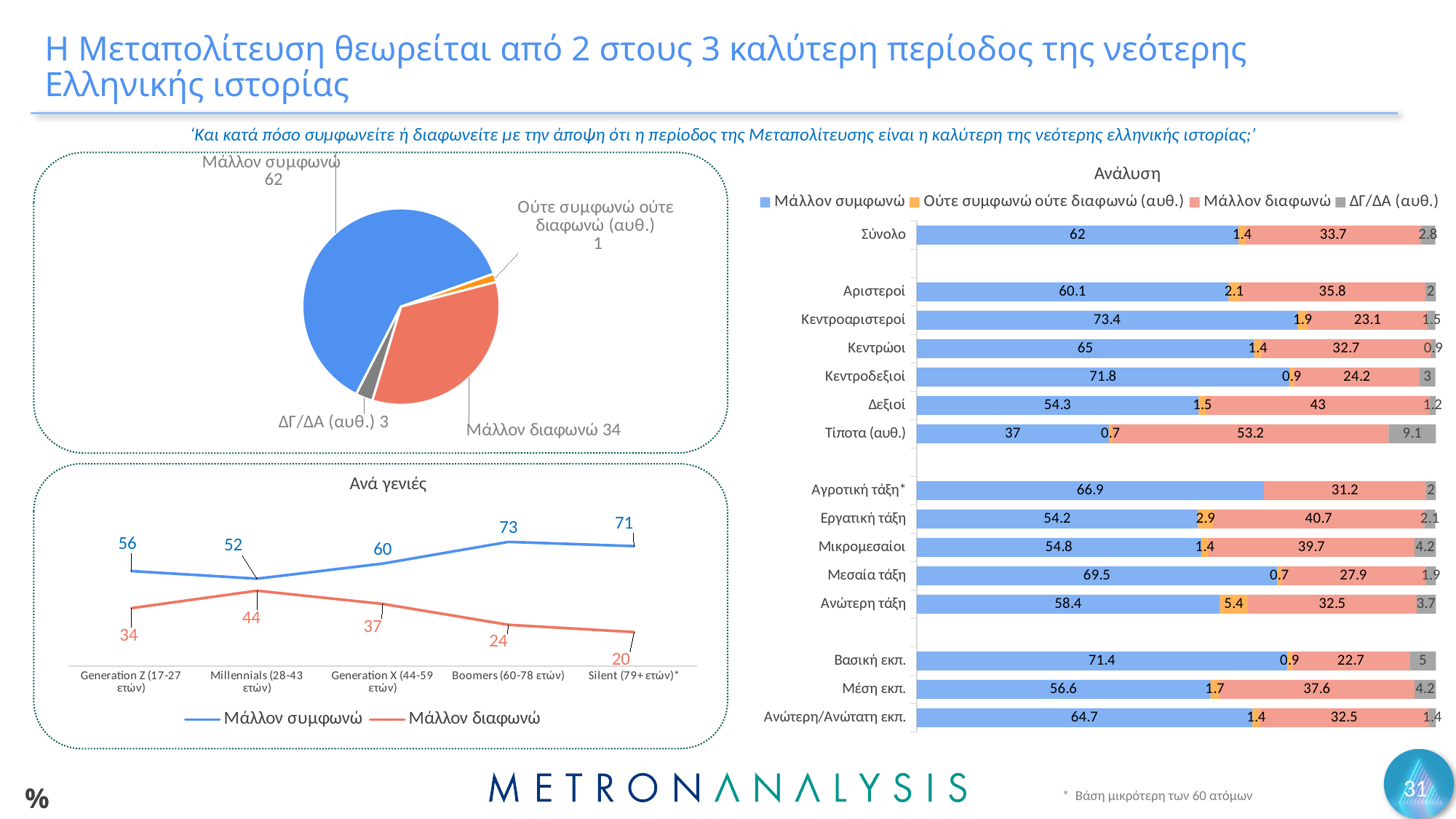
In the pie chart on the top left, which category has the smallest slice? Ούτε συμφωνώ ούτε διαφωνώ (αυθ.) In the 'Ανά γενιές' chart, which generation has the highest Μάλλον διαφωνώ value? Millennials (28-43 ετών) How many series does the legend of the 'Ανά γενιές' chart list? 2 How many series does the legend of the 'Ανάλυση' chart list? 4 In the pie chart on the top left, what is the value for Μάλλον συμφωνώ? 62 In the 'Ανά γενιές' chart, what is the difference between Μάλλον συμφωνώ and Μάλλον διαφωνώ for Silent (79+ ετών)*? 51 What type of chart is the 'Ανά γενιές' chart? Line chart In the 'Ανά γενιές' chart, what is the Μάλλον συμφωνώ value for Boomers (60-78 ετών)? 73 In the 'Ανάλυση' chart, is the Μάλλον συμφωνώ value larger for Κεντροδεξιοί or for Δεξιοί? Κεντροδεξιοί In the 'Ανάλυση' chart, what is the Μάλλον διαφωνώ value for Τίποτα (αυθ.)? 53.2 In the 'Ανάλυση' chart, which category has the highest Μάλλον συμφωνώ value? Κεντροαριστεροί How many slices does the pie chart on the top left have? 4